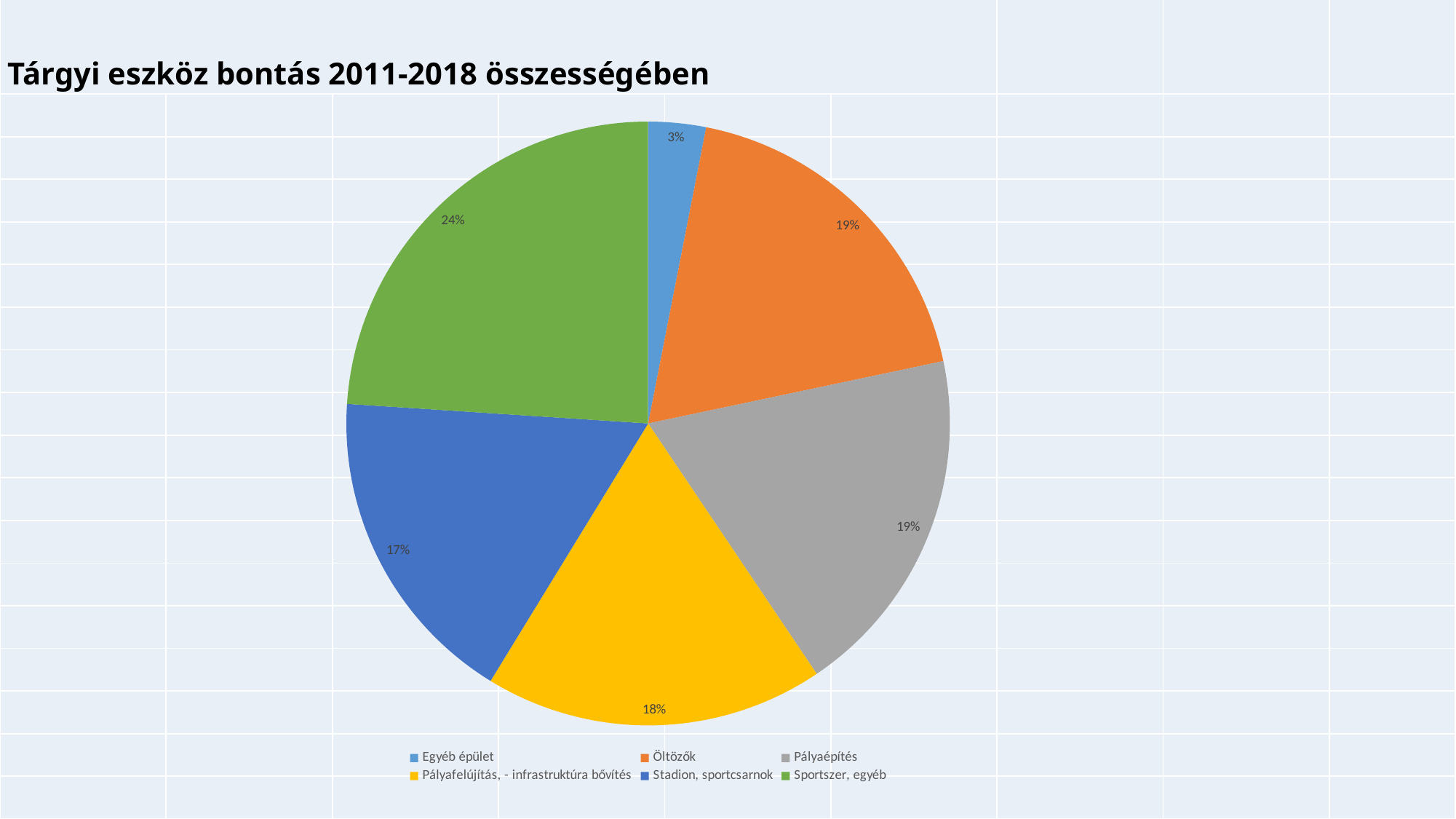
What kind of chart is shown on the slide? pie chart What is the title of the chart? Tárgyi eszköz bontás 2011-2018 összességében What share of the pie does Sportszer, egyéb represent? 24% Which is larger, the share for Sportszer, egyéb or the share for Stadion, sportcsarnok? Sportszer, egyéb What is the value shown for Pályafelújítás, - infrastruktúra bővítés? 18% How many slices does the pie chart have? 6 What is the value shown for Öltözők? 19% Which category has the smallest share of the pie? Egyéb épület What share of the pie does Egyéb épület represent? 3% What is the value shown for Stadion, sportcsarnok? 17% Which category has the largest share of the pie? Sportszer, egyéb What is the difference in percentage points between the share for Sportszer, egyéb and the share for Egyéb épület? 21